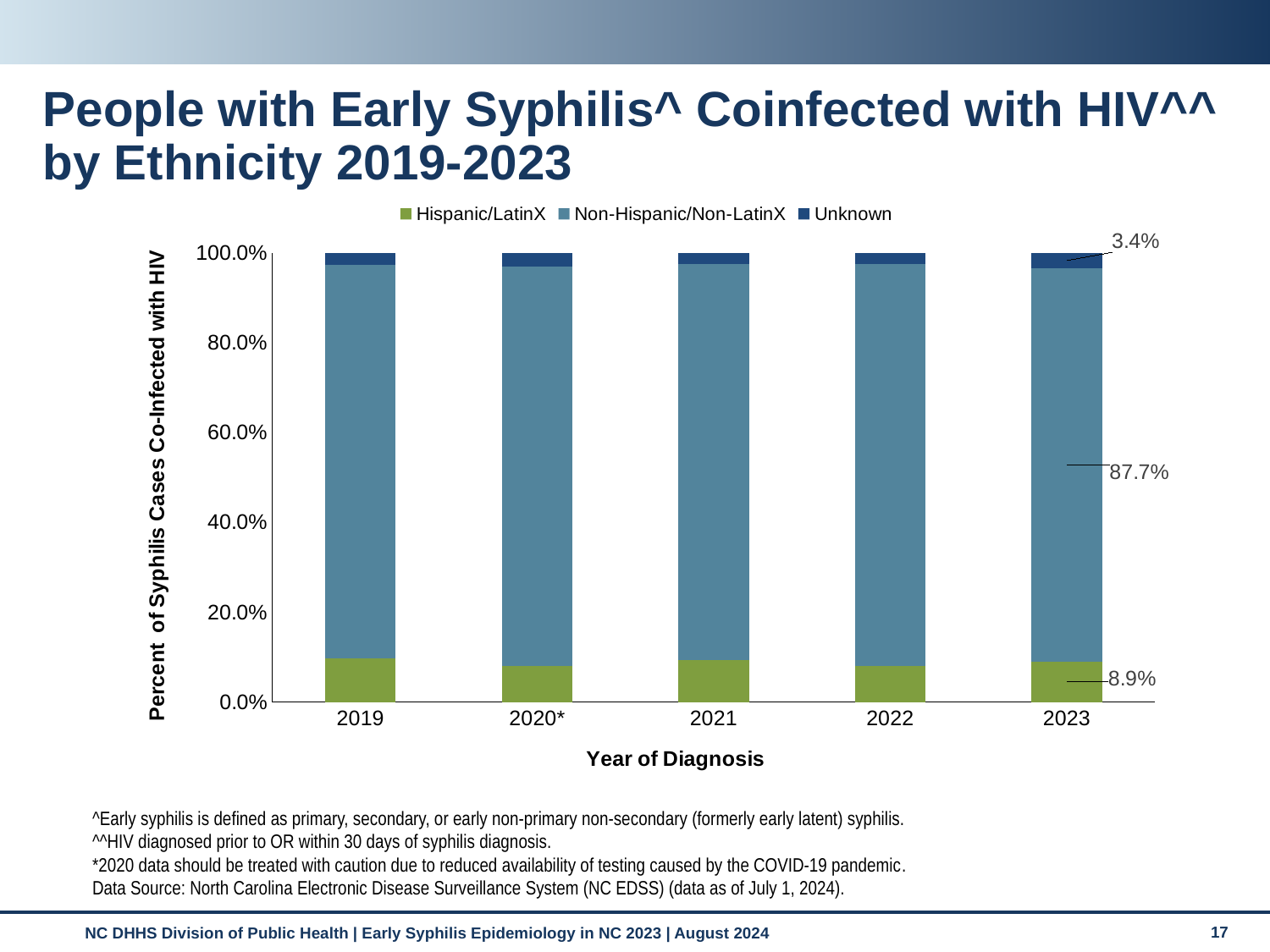
Is the Hispanic/LatinX value for 2019 greater or less than 20.0%? less What is the difference in percentage points between the Non-Hispanic/Non-LatinX and Hispanic/LatinX values for 2023? 78.8 percentage points What is the title of the x axis? Year of Diagnosis What percentage of early syphilis cases co-infected with HIV in 2023 were Hispanic/LatinX? 8.9% How many series does the legend list? 3 What kind of chart is shown on the slide? Stacked bar chart What percentage of early syphilis cases co-infected with HIV in 2023 were Non-Hispanic/Non-LatinX? 87.7% How many years of diagnosis are shown on the x axis? 5 In 2023, which is larger: the Hispanic/LatinX value or the Unknown value? Hispanic/LatinX What percentage of early syphilis cases co-infected with HIV in 2023 had Unknown ethnicity? 3.4% In 2023, which ethnicity group has the smallest share of the stacked bar? Unknown In 2023, which ethnicity group has the largest share of the stacked bar? Non-Hispanic/Non-LatinX